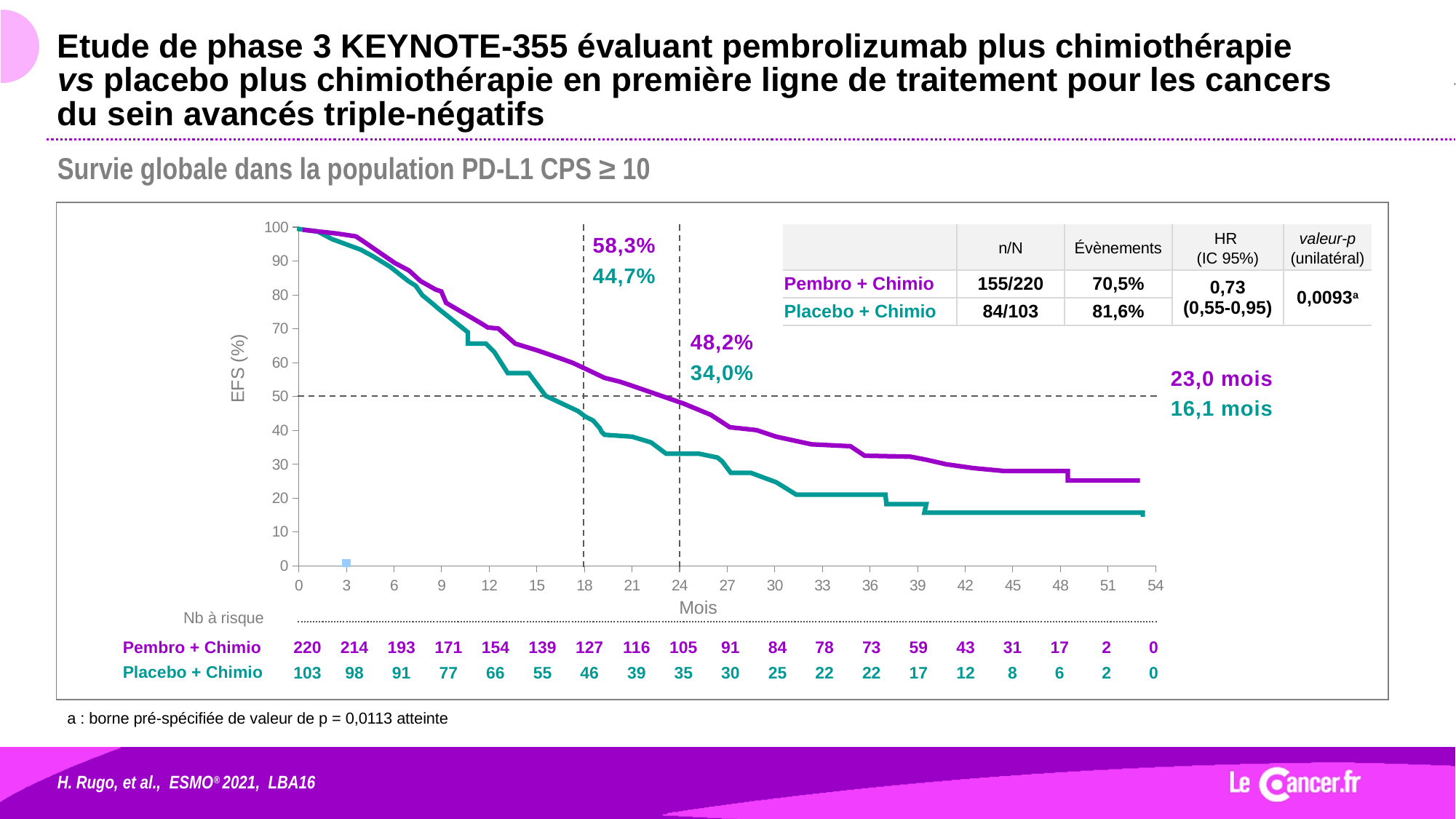
What is the difference in EFS rate at 24 months between the Pembro + Chimio and Placebo + Chimio arms? 14,2% How many patients were at risk in the Placebo + Chimio arm at 12 months? 66 What kind of chart is shown on the slide? Line chart (Kaplan-Meier survival curve) What is the EFS rate at 24 months for the Placebo + Chimio arm? 34,0% How many treatment arms (series) are plotted on the chart? 2 What is the EFS rate at 18 months for the Placebo + Chimio arm? 44,7% What is the EFS rate at 24 months for the Pembro + Chimio arm? 48,2% Which arm has the higher EFS rate at 18 months, Pembro + Chimio or Placebo + Chimio? Pembro + Chimio What is the median survival for the Pembro + Chimio arm? 23,0 mois What is the hazard ratio (HR) shown in the table? 0,73 What is the median survival for the Placebo + Chimio arm? 16,1 mois What is the EFS rate at 18 months for the Pembro + Chimio arm? 58,3%